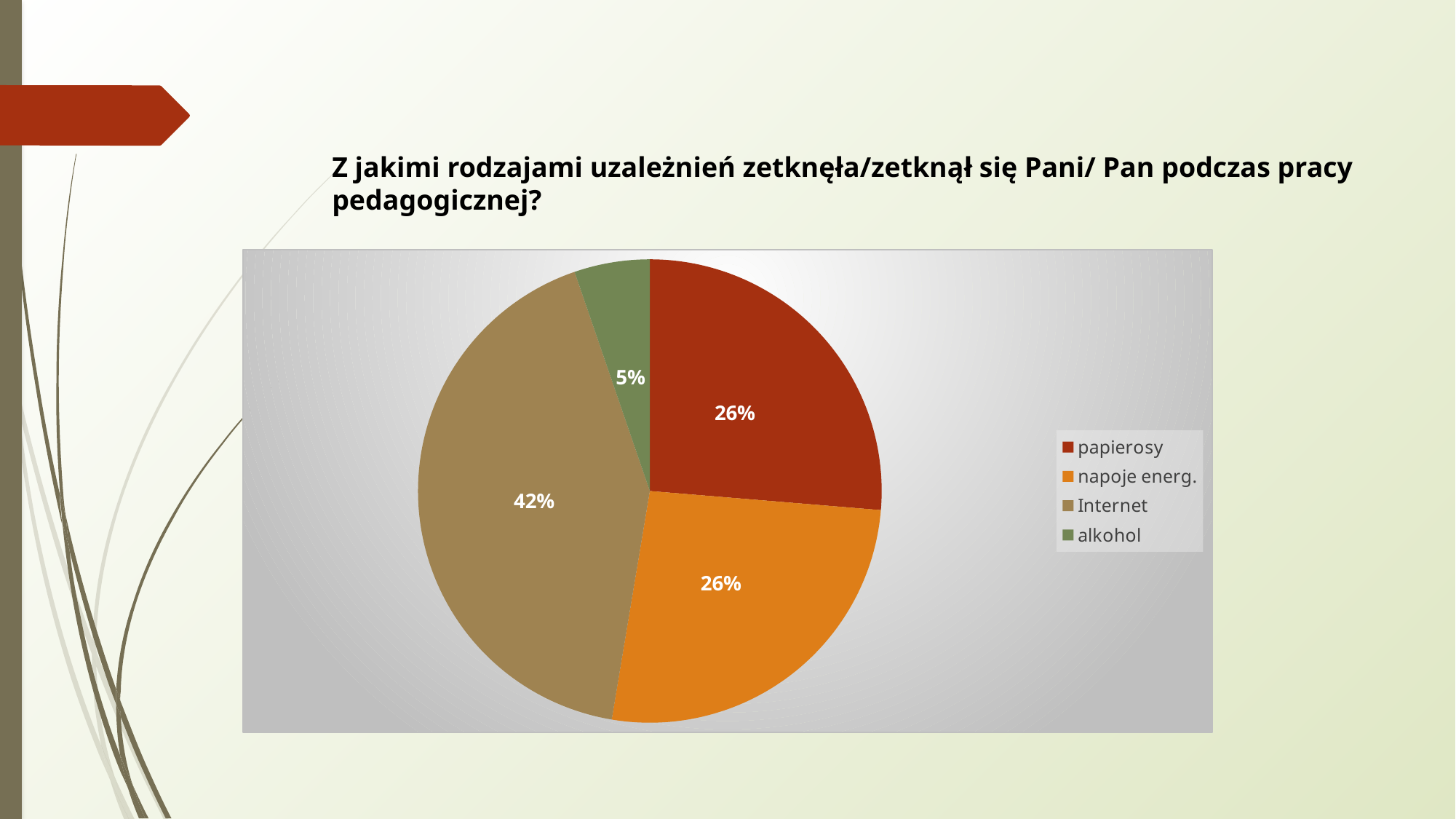
What share of the pie does alkohol have? 5% Which category has the largest slice of the pie? Internet What colour is the slice for alkohol? green Which legend entry is listed first? papierosy How many categories does the pie chart show? 4 What share of the pie does napoje energ. have? 26% Which is larger, the slice for Internet or the slice for papierosy? Internet What kind of chart is shown on the slide? pie chart What is the difference in percentage points between Internet and alkohol? 37 What share of the pie does papierosy have? 26% Which category has the smallest slice of the pie? alkohol